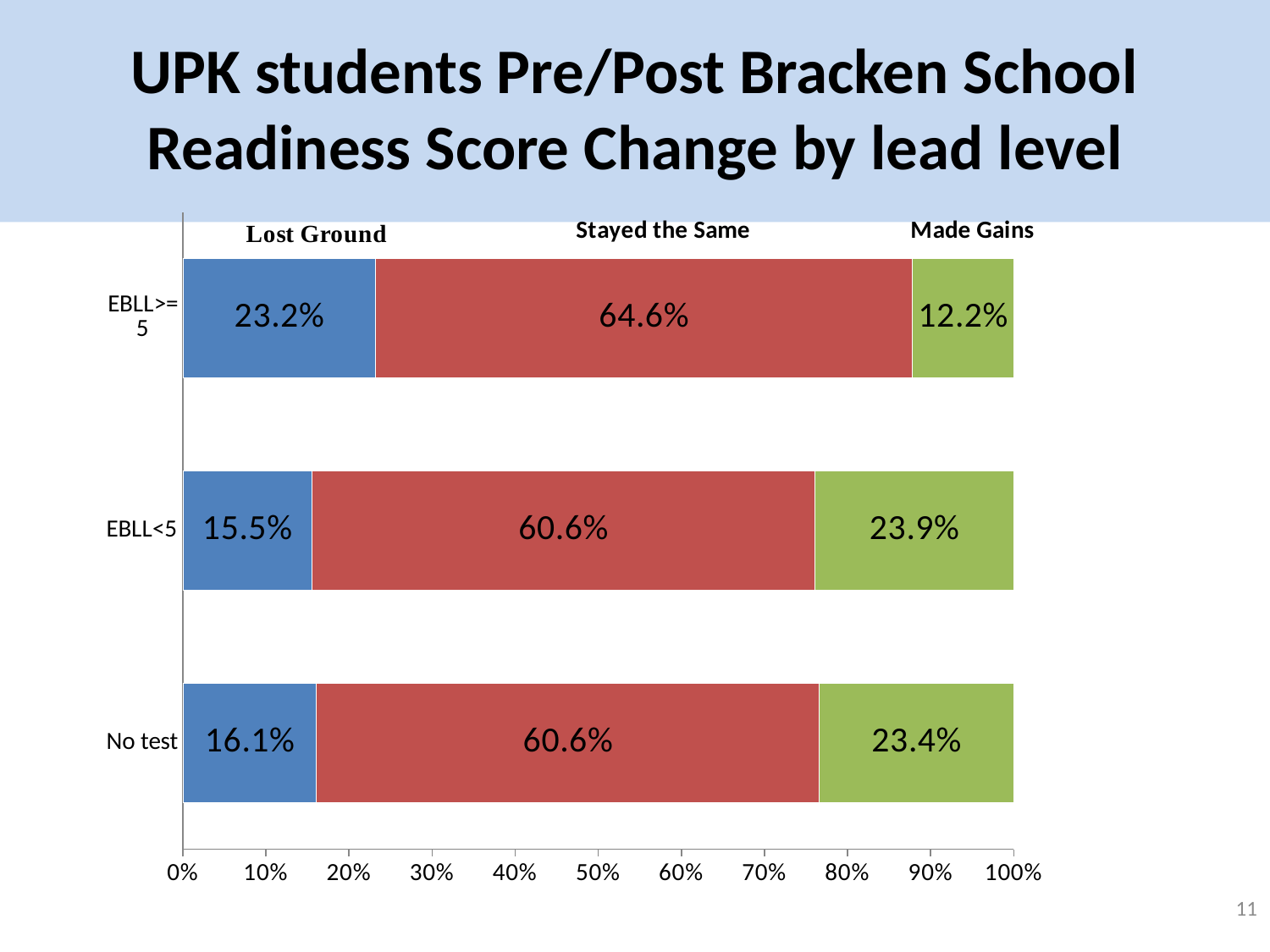
What is the difference between the Made Gains percentage for EBLL<5 and for EBLL>=5? 11.7% What percentage of EBLL<5 students Made Gains? 23.9% What percentage of EBLL>=5 students Lost Ground? 23.2% What kind of chart is shown on the slide? Stacked bar chart What percentage of No test students Stayed the Same? 60.6% How many lead level categories are shown on the chart? 3 Which lead level group has the lowest percentage of students who Made Gains? EBLL>=5 How many series does the chart legend list? 3 What colour represents the Made Gains series? Green Which lead level group has the highest percentage of students who Lost Ground? EBLL>=5 Which is larger: the Lost Ground percentage for EBLL<5 or for No test? No test Is the Stayed the Same percentage for EBLL>=5 greater or less than 60%? greater